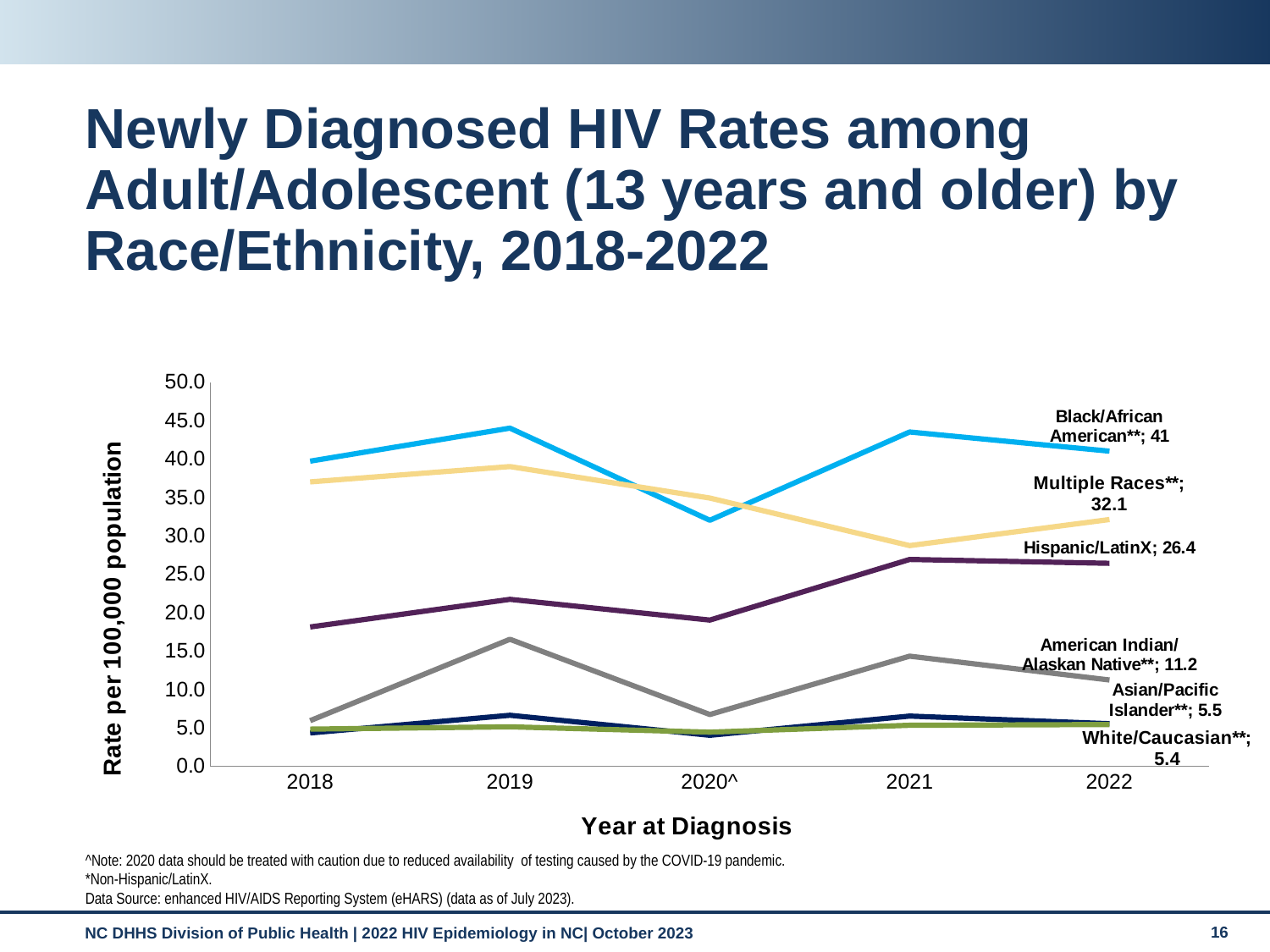
How many race/ethnicity series are plotted on the chart? 6 In 2022, which is larger: the rate for Multiple Races or the rate for Hispanic/LatinX? Multiple Races How many years are shown on the x axis? 5 What is the difference between the 2022 rates for Black/African American and Multiple Races? 8.9 What is the rate for Multiple Races in 2022? 32.1 What is the rate for American Indian/Alaskan Native in 2022? 11.2 Which race/ethnicity group has the highest rate in 2022? Black/African American What is the rate for Hispanic/LatinX in 2022? 26.4 What kind of chart is shown on the slide? Line chart What is the newly diagnosed HIV rate for Black/African American in 2022? 41 Is the rate for Black/African American in 2020 greater or less than 35.0? less Which race/ethnicity group has the lowest rate in 2022? White/Caucasian